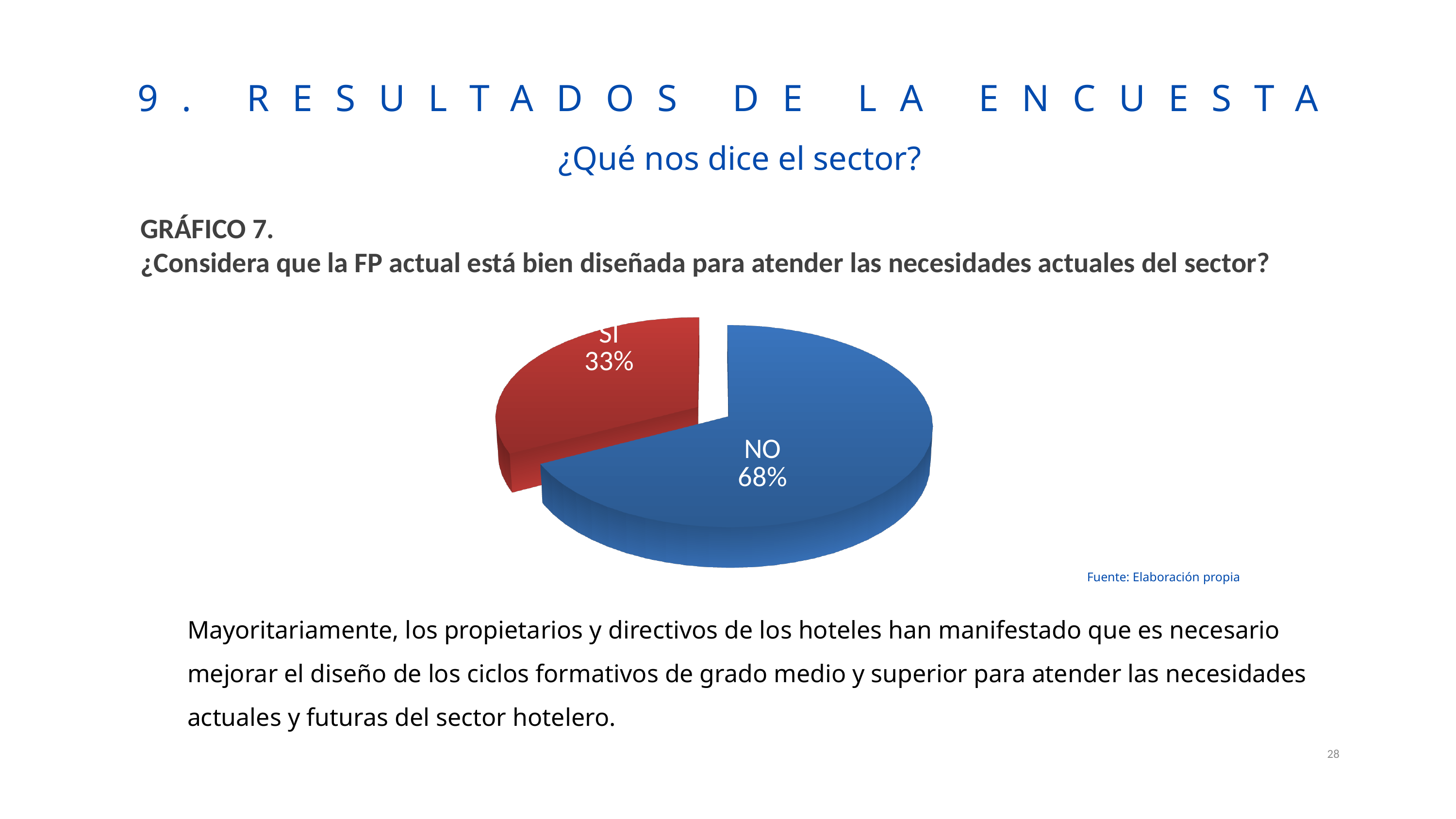
Which slice is larger, NO or SI? NO What kind of chart is shown on the slide? Pie chart What percentage of respondents answered NO? 68% What percentage of respondents answered SI? 33% How many slices does the pie chart have? 2 Which response has the smallest share of the pie? SI What share of the pie does the NO slice represent? 68% What colour is the NO slice? Blue What is the difference in percentage points between the NO and SI slices? 35 What colour is the SI slice? Red Which response has the largest share of the pie? NO